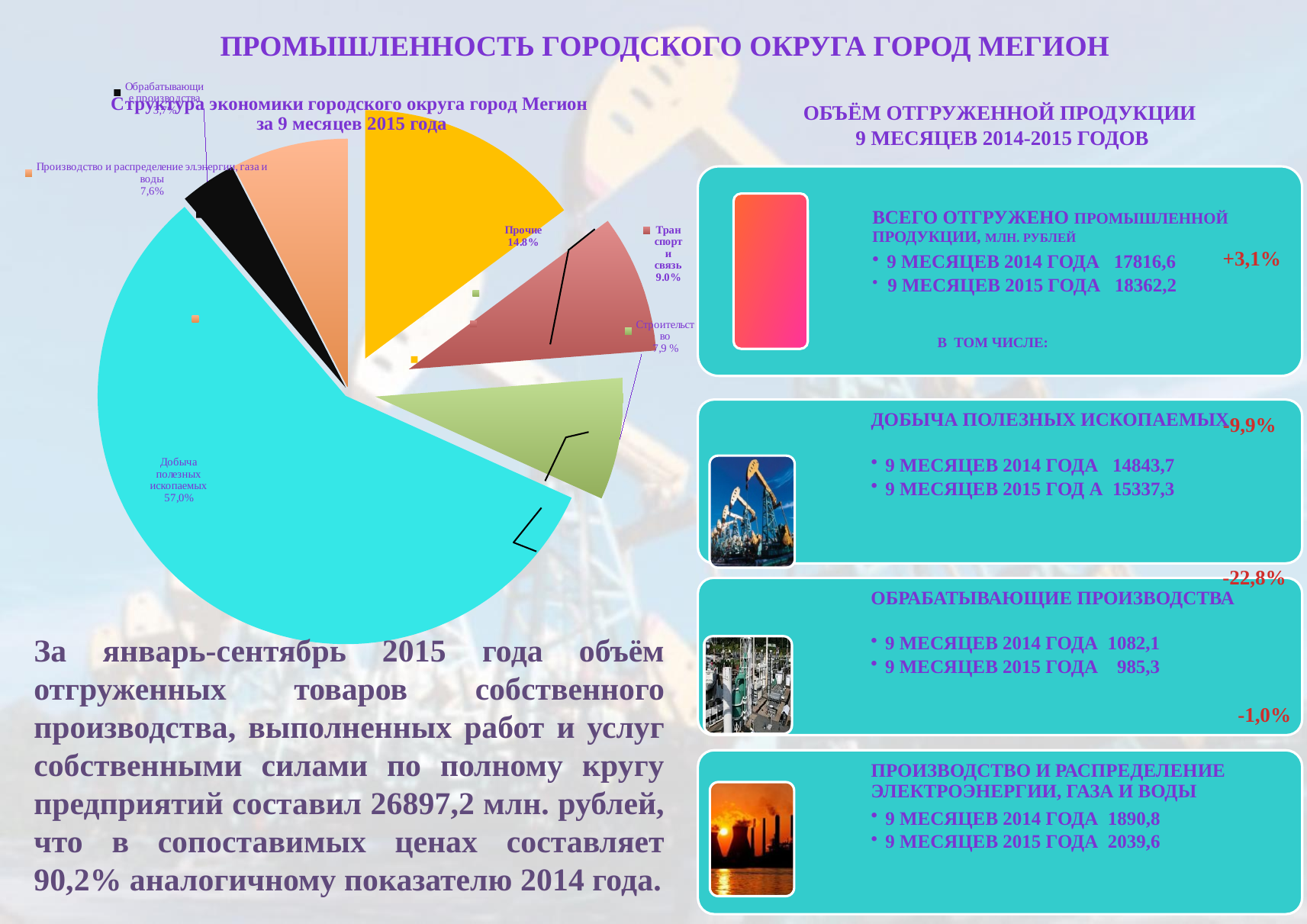
Which category has the largest slice of the pie? Добыча полезных ископаемых Which slice is larger: Прочие or Транспорт и связь? Прочие What share of the pie does Производство и распределение эл.энергии, газа и воды have? 7,6% What is the title of the pie chart? Структура экономики городского округа город Мегион за 9 месяцев 2015 года What share of the pie does Транспорт и связь have? 9.0% How many slices does the pie chart have? 6 Which category has the smallest slice of the pie? Обрабатывающие производства What is the difference in percentage points between the Добыча полезных ископаемых slice and the Прочие slice? 42.2 What share of the pie does Добыча полезных ископаемых have? 57,0% What share of the pie does Строительство have? 7,9 % What kind of chart is shown on the slide? pie chart What share of the pie does Прочие have? 14.8%